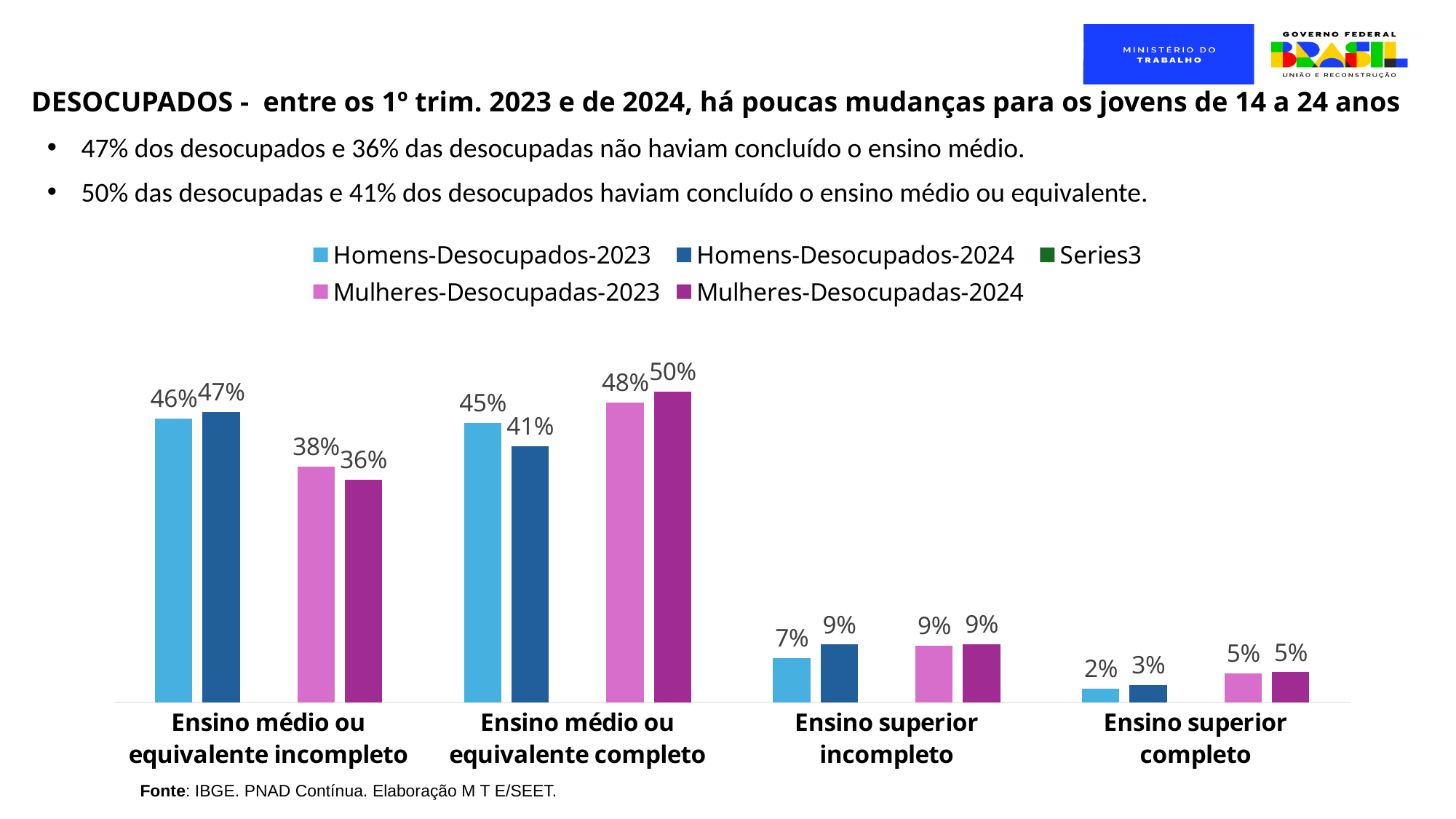
What is the value for Mulheres-Desocupadas-2023 in the 'Ensino superior completo' category? 5% How many series does the chart's legend list? 5 What is the value for Homens-Desocupados-2023 in the 'Ensino médio ou equivalente incompleto' category? 46% What is the source cited below the chart? IBGE. PNAD Contínua. Elaboração M T E/SEET. What is the difference between Homens-Desocupados-2023 and Homens-Desocupados-2024 in the 'Ensino médio ou equivalente completo' category? 4% How many categories are shown on the x axis of the chart? 4 What kind of chart is shown on the slide? Bar chart Which category has the lowest value for Homens-Desocupados-2023? Ensino superior completo In the 'Ensino médio ou equivalente incompleto' category, which is larger: Homens-Desocupados-2024 or Mulheres-Desocupadas-2024? Homens-Desocupados-2024 What is the value for Mulheres-Desocupadas-2024 in the 'Ensino médio ou equivalente completo' category? 50% What is the value for Homens-Desocupados-2024 in the 'Ensino superior incompleto' category? 9% Which category has the highest value for Mulheres-Desocupadas-2024? Ensino médio ou equivalente completo